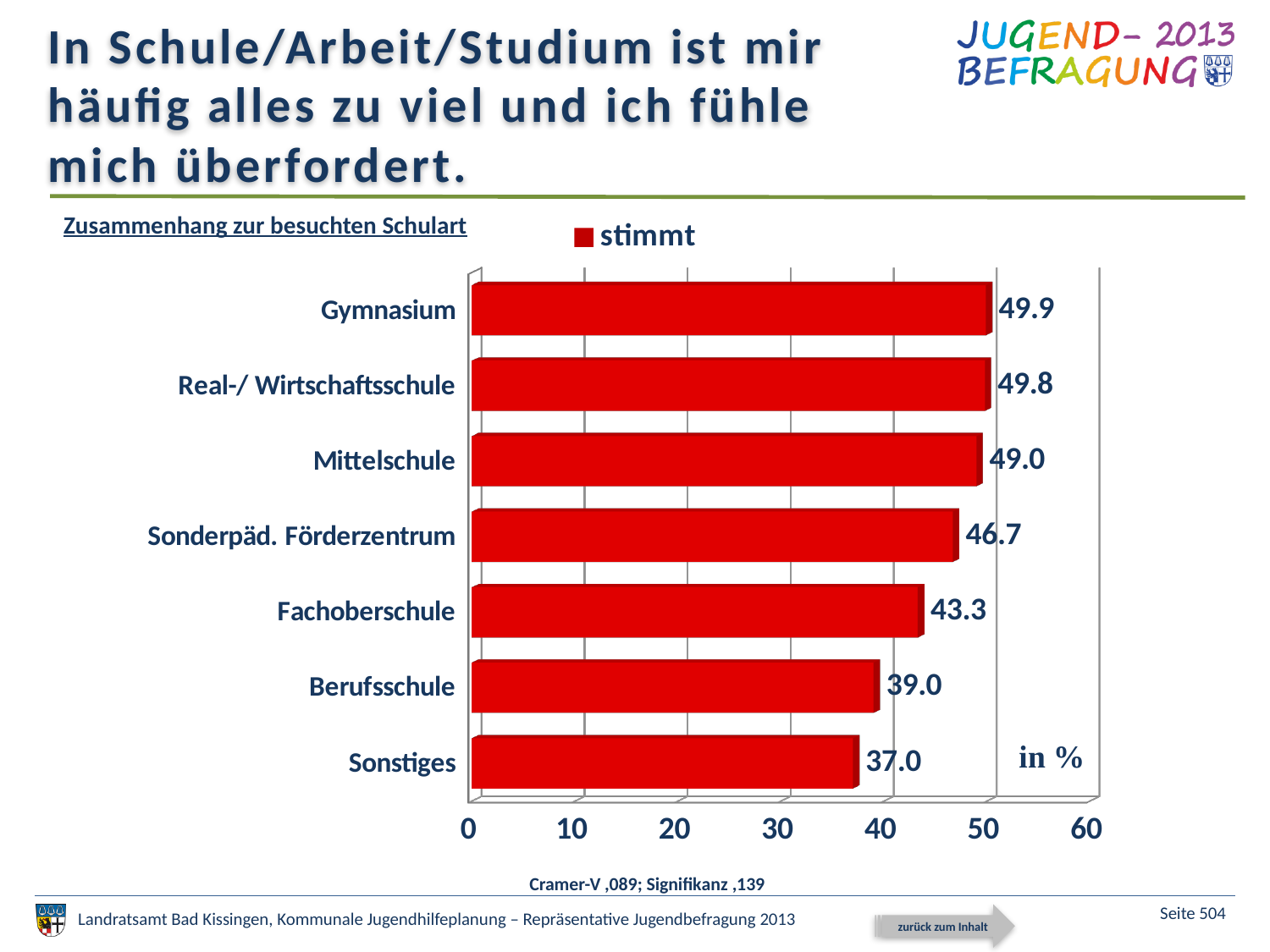
What is the value for Real-/ Wirtschaftsschule? 49.8 What is the value for Berufsschule? 39.0 Is the value for Berufsschule greater or less than 40? less What is the difference between the values for Mittelschule and Berufsschule? 10.0 What kind of chart is shown on the slide? bar chart How many series does the legend list? 1 Which category has the lowest value? Sonstiges What is the difference between the values for Gymnasium and Sonstiges? 12.9 How many categories are shown in the chart? 7 What is the value for Sonderpäd. Förderzentrum? 46.7 Which is larger, the value for Fachoberschule or the value for Berufsschule? Fachoberschule What is the value for Gymnasium? 49.9